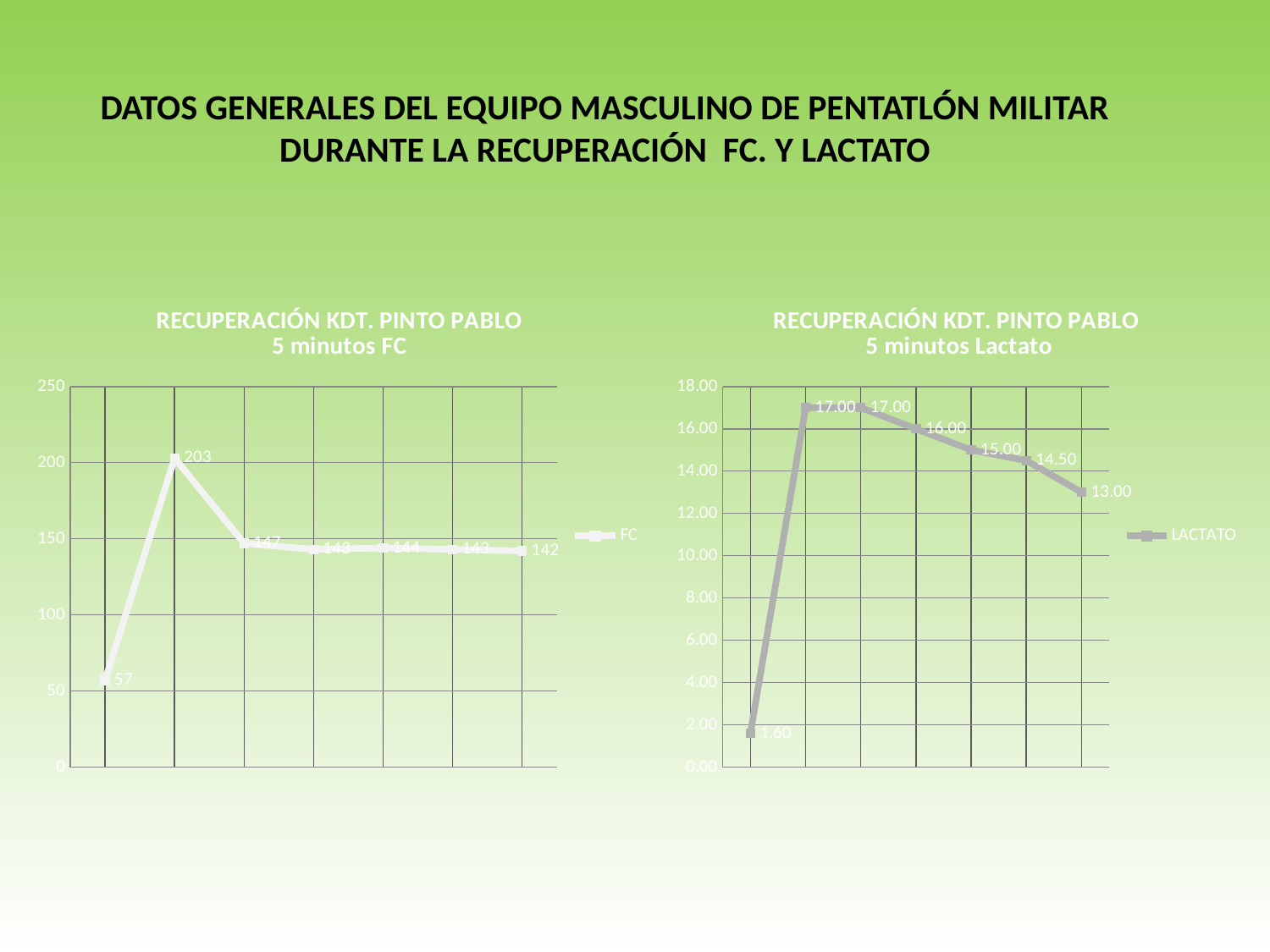
In the right chart (5 minutos Lactato), what is the lowest value plotted? 1.60 What type of chart is the left chart (5 minutos FC)? Line chart In the right chart (5 minutos Lactato), which is larger: the fourth point or the fifth point? The fourth point (16.00) In the left chart (5 minutos FC), what is the value of the first data point? 57 In the left chart (5 minutos FC), how many data points are plotted? 7 What series name does the legend of the right chart (5 minutos Lactato) show? LACTATO In the right chart (5 minutos Lactato), what is the value of the first data point? 1.60 In the right chart (5 minutos Lactato), what is the value of the last data point? 13.00 In the left chart (5 minutos FC), what is the difference between the second point (203) and the third point (147)? 56 In the left chart (5 minutos FC), what is the value of the last data point? 142 In the left chart (5 minutos FC), what is the highest value plotted? 203 In the right chart (5 minutos Lactato), do the values rise or fall from the third point to the last point? Fall